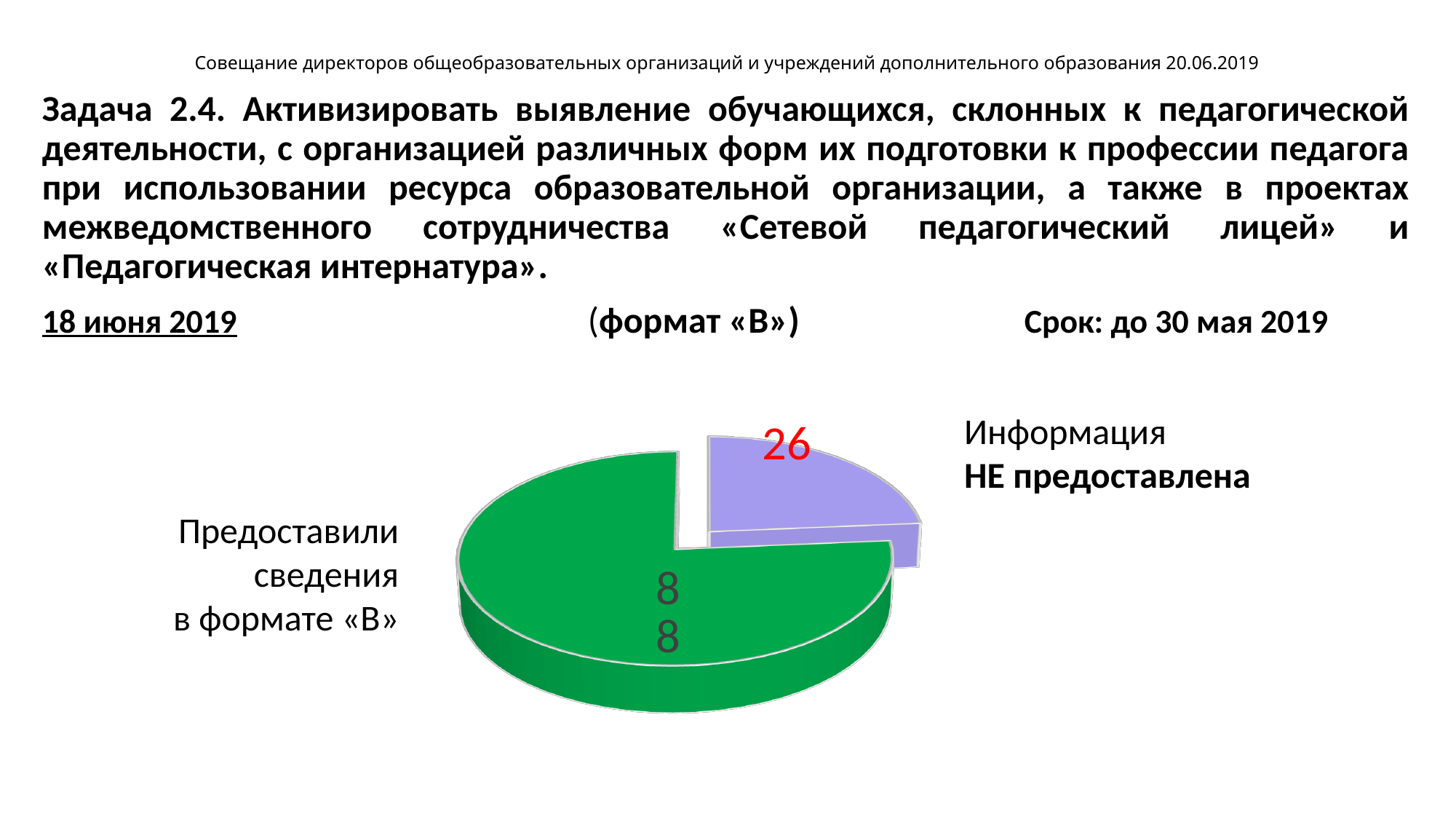
What colour is the slice for Информация НЕ предоставлена? purple What is the difference between the number that provided information in format «В» and the number that did not? 62 Which slice of the pie chart is the smallest? Информация НЕ предоставлена What value is shown for the green slice (Предоставили сведения в формате «В»)? 88 What is the total of the two values shown in the pie chart? 114 How many slices does the pie chart have? 2 Which slice of the pie chart is the largest? Предоставили сведения в формате «В» In what colour is the value 26 printed on the chart? red Which is larger: the number that provided information (Предоставили сведения) or the number that did not (НЕ предоставлена)? Предоставили сведения What kind of chart is shown on the slide? pie chart What value is shown for the purple slice (Информация НЕ предоставлена)? 26